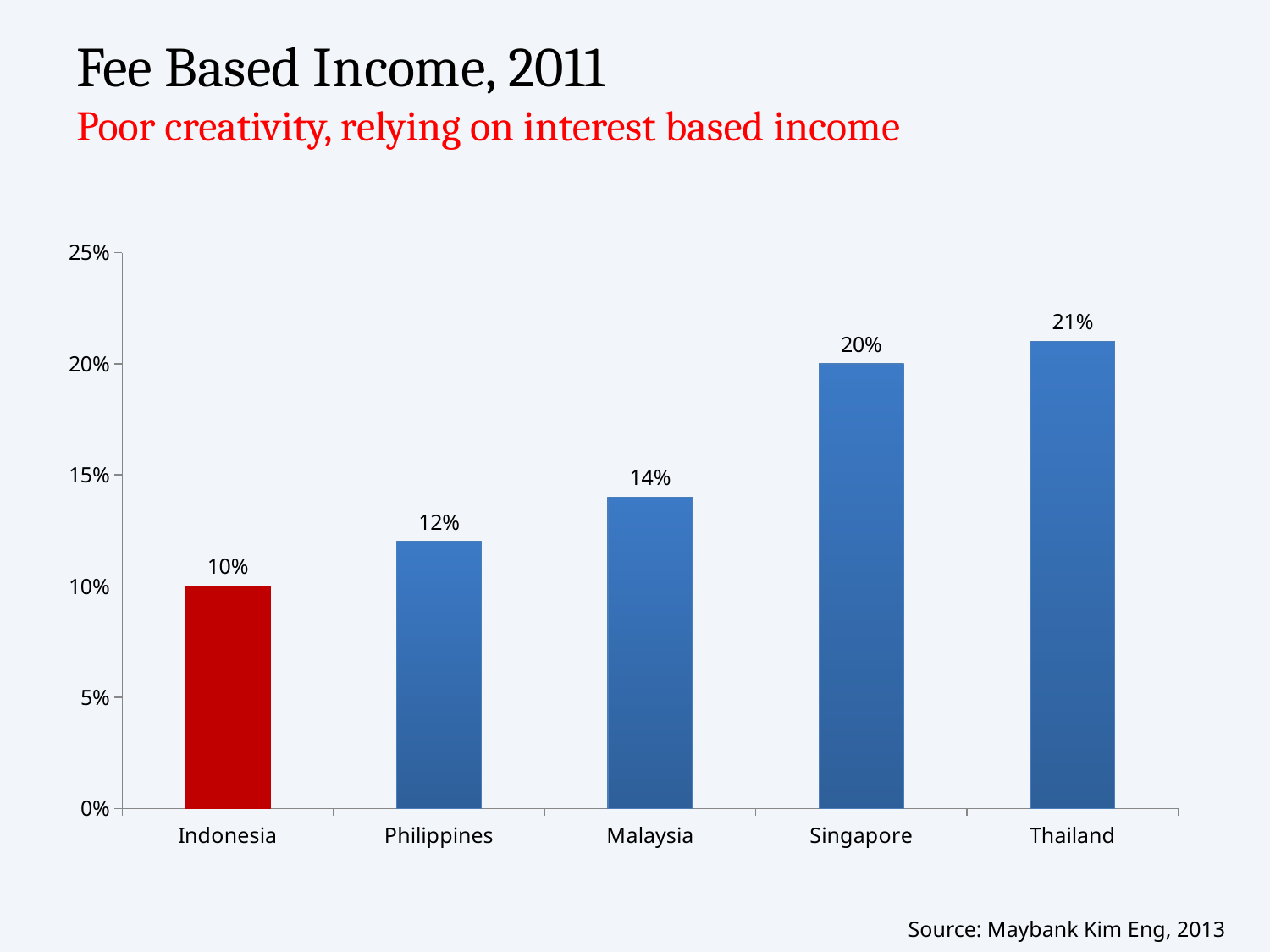
Which has a higher fee based income, Philippines or Singapore? Singapore What kind of chart is shown on the slide? Bar chart How many countries are shown in the chart? 5 Which country has the highest fee based income? Thailand What is the fee based income value for Singapore? 20% What is the difference between Malaysia's and Philippines' fee based income? 2% What is the fee based income value for Indonesia? 10% Which country has the lowest fee based income? Indonesia Is the value for Malaysia greater or less than 15%? less What is the difference between Thailand's and Indonesia's fee based income? 11% What is the fee based income value for Malaysia? 14% Which country's bar is coloured red? Indonesia